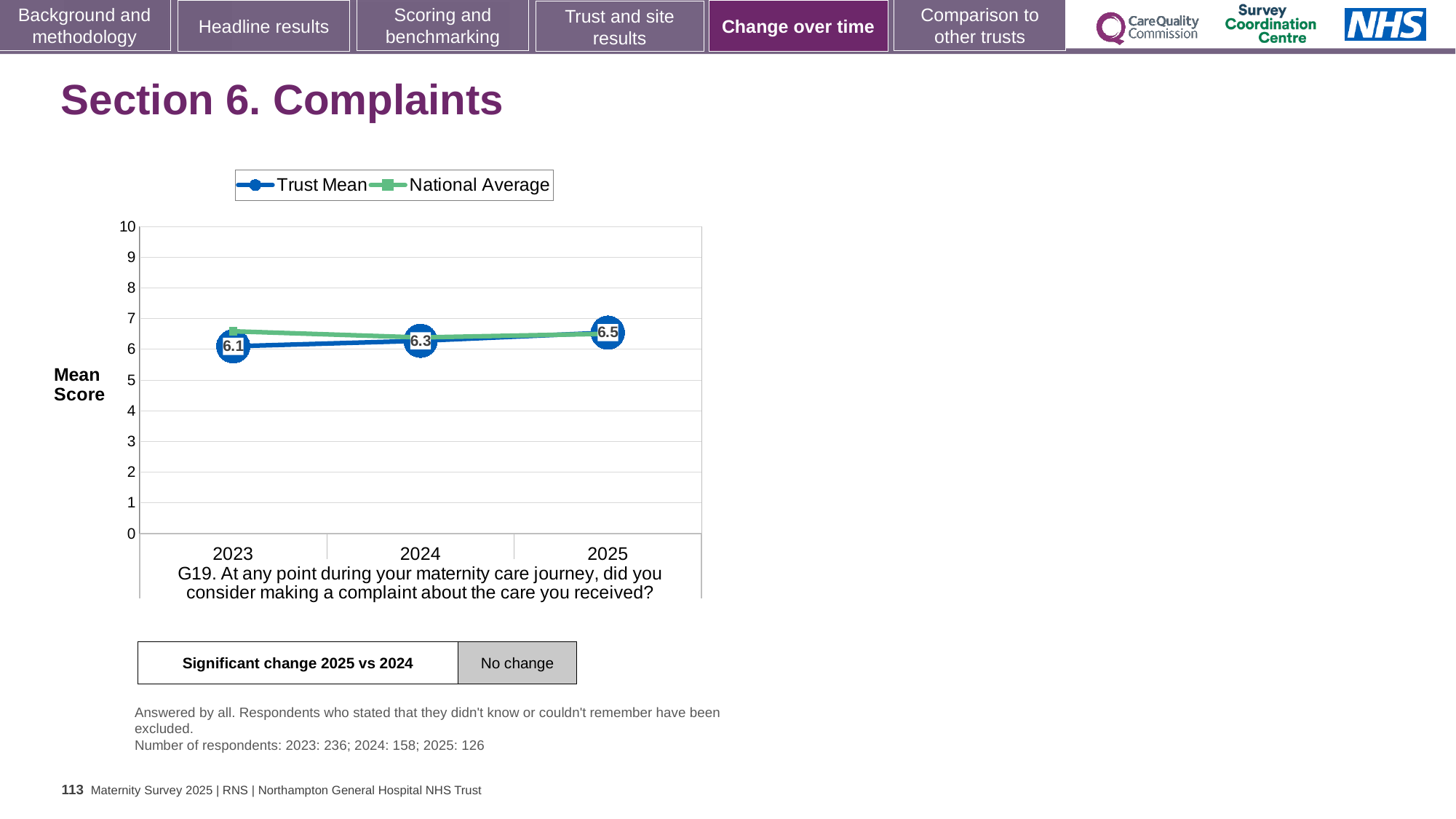
What is the Trust Mean value for 2024? 6.3 What is the Trust Mean value for 2023? 6.1 In 2023, which is larger: the Trust Mean or the National Average? National Average In which year is the Trust Mean highest? 2025 How many years are plotted on the x axis? 3 In which year is the Trust Mean lowest? 2023 What kind of chart is shown? line chart What is the difference between the Trust Mean in 2025 and in 2023? 0.4 What is the Trust Mean value for 2025? 6.5 Does the Trust Mean rise or fall from 2023 to 2025? rise How many series does the legend list? 2 Is the National Average value for 2023 greater or less than 6? greater